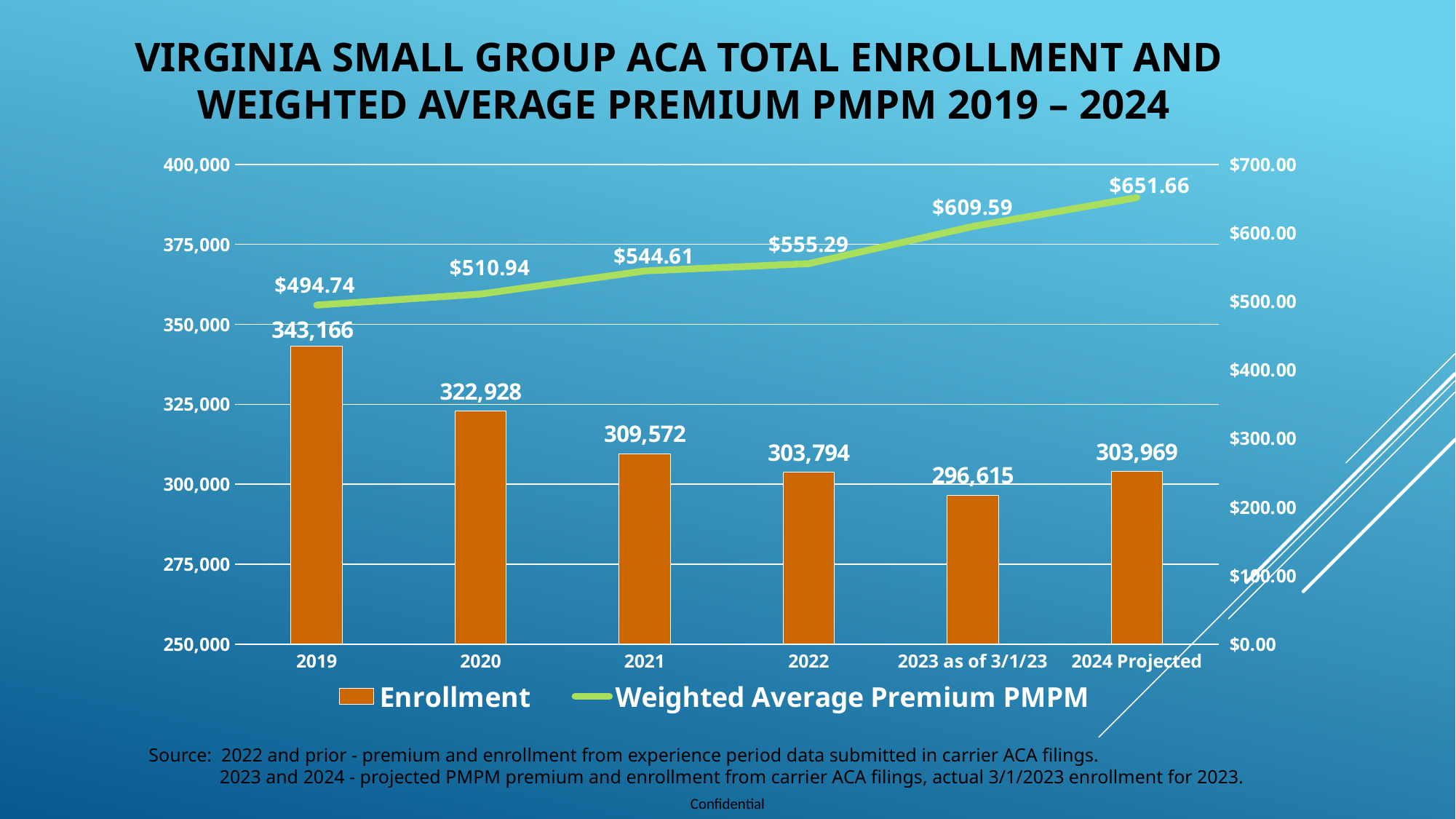
Does the Weighted Average Premium PMPM rise or fall from 2019 to 2024 Projected? rise What is the difference in Enrollment between 2019 and 2020? 20,238 What is the Weighted Average Premium PMPM for 2024 Projected? $651.66 What is the Enrollment value for 2023 as of 3/1/23? 296,615 Which is larger, the Enrollment for 2022 or for 2024 Projected? 2024 Projected What is the Enrollment value for 2019? 343,166 How many years are shown on the x axis? 6 Which year has the highest Enrollment? 2019 What is the Weighted Average Premium PMPM for 2021? $544.61 Which year has the lowest Enrollment? 2023 as of 3/1/23 What colour is the Weighted Average Premium PMPM line? green How many series does the legend list? 2